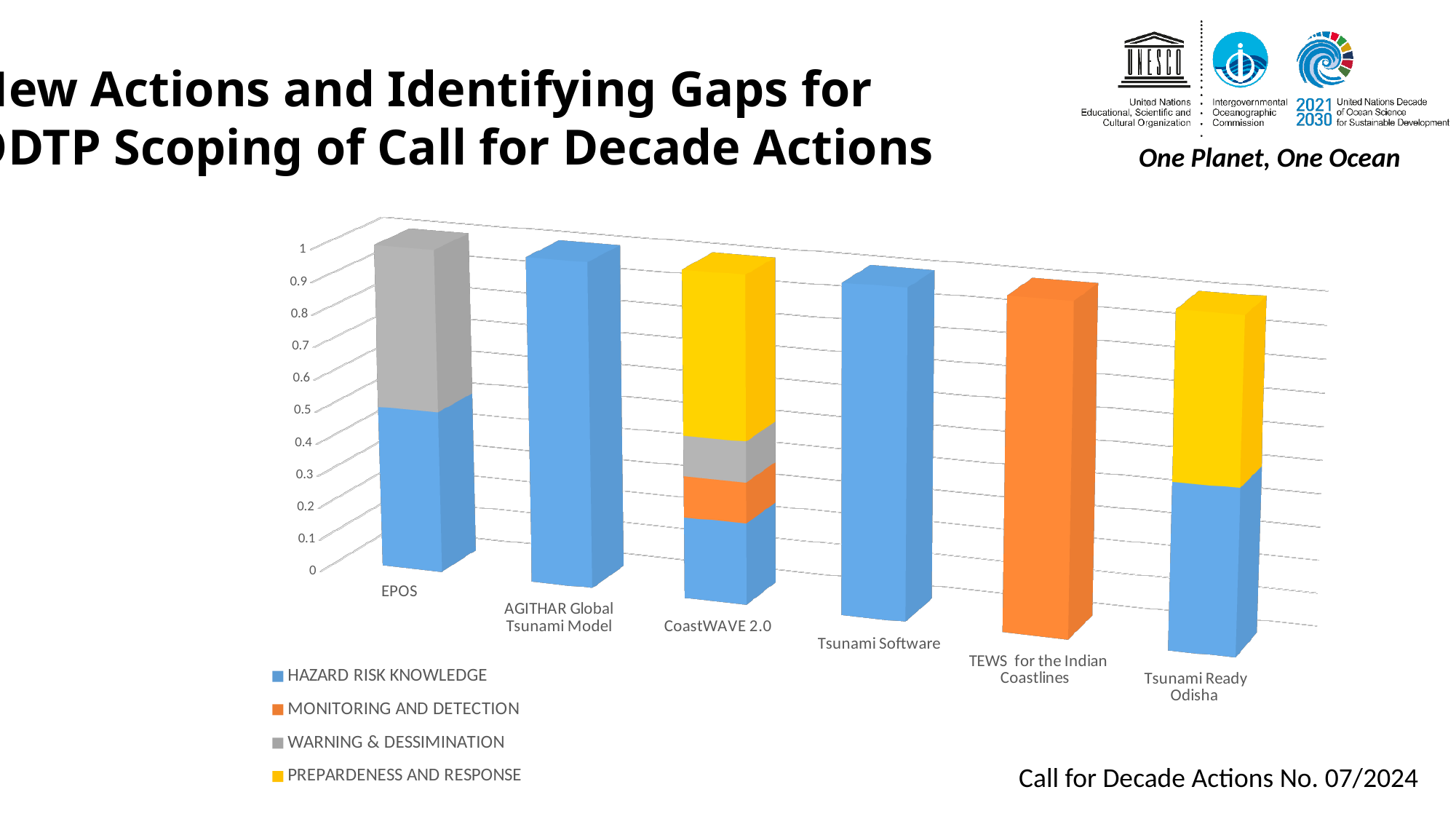
Which series is shown in yellow in the chart legend? PREPARDENESS AND RESPONSE How many series does the chart legend list? 4 How many categories (actions) are shown along the x axis of the chart? 6 Is the HAZARD RISK KNOWLEDGE value for EPOS greater or less than 0.8? less Which series is shown in blue in the chart legend? HAZARD RISK KNOWLEDGE Which series appears in the EPOS bar besides HAZARD RISK KNOWLEDGE? WARNING & DESSIMINATION Which category's bar contains all four series? CoastWAVE 2.0 Which category's bar consists only of the MONITORING AND DETECTION series? TEWS for the Indian Coastlines What kind of chart is shown on the slide? Stacked bar chart Which two categories have bars made up entirely of HAZARD RISK KNOWLEDGE? AGITHAR Global Tsunami Model and Tsunami Software Is the HAZARD RISK KNOWLEDGE value for CoastWAVE 2.0 greater or less than 0.5? less